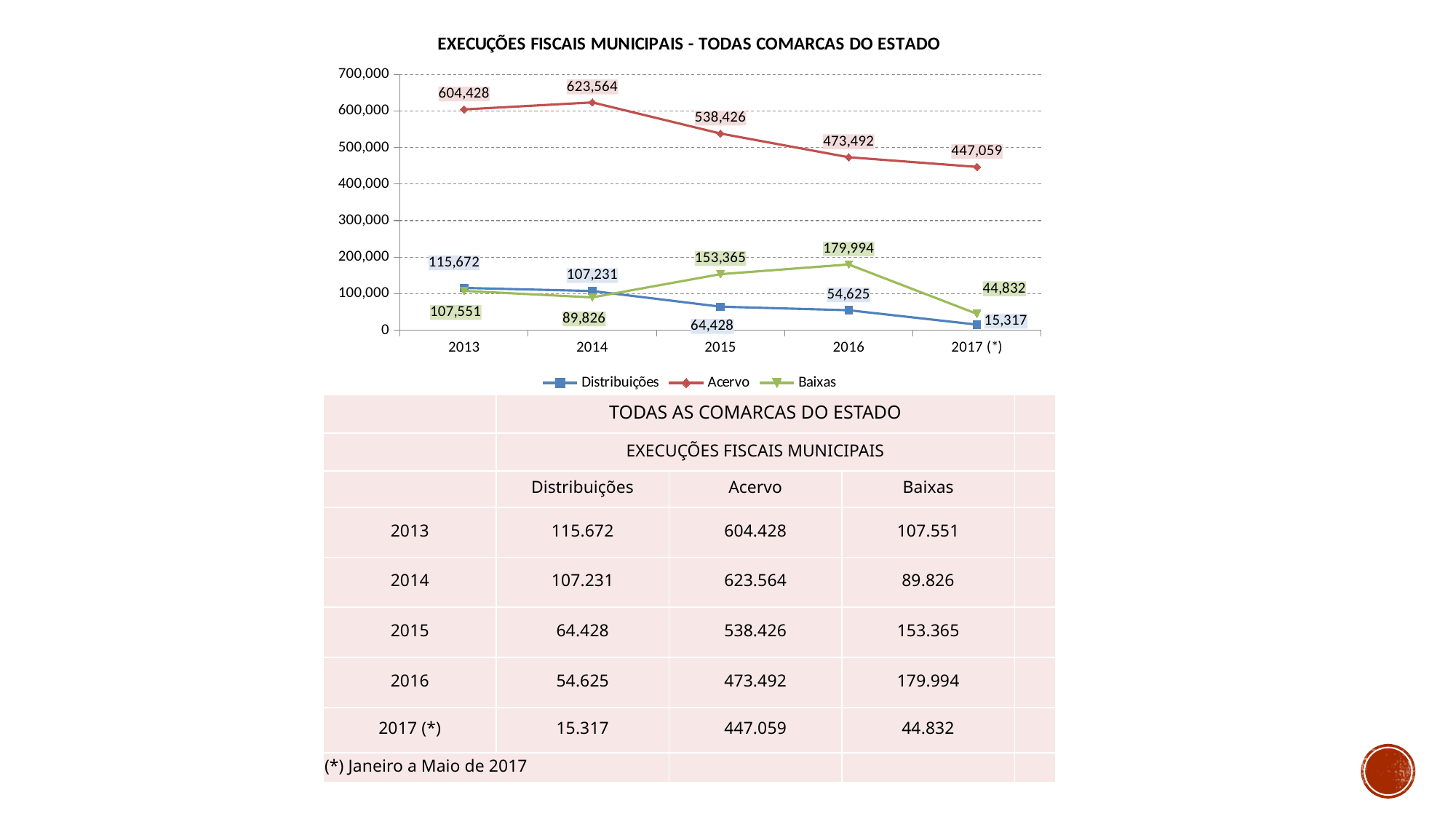
What kind of chart is shown? Line chart What is the value of Acervo in 2015? 538,426 What is the difference between Baixas in 2016 and Baixas in 2015? 26,629 How many years are plotted on the x axis? 5 In which year is Acervo highest? 2014 How many series does the legend list? 3 What is the value of Distribuições in 2017 (*)? 15,317 What is the difference between Acervo in 2014 and Acervo in 2013? 19,136 Does the Distribuições series rise or fall from 2013 to 2017 (*)? Fall In which year is Distribuições lowest? 2017 (*) What is the value of Baixas in 2016? 179,994 In 2015, which is larger: Baixas or Distribuições? Baixas